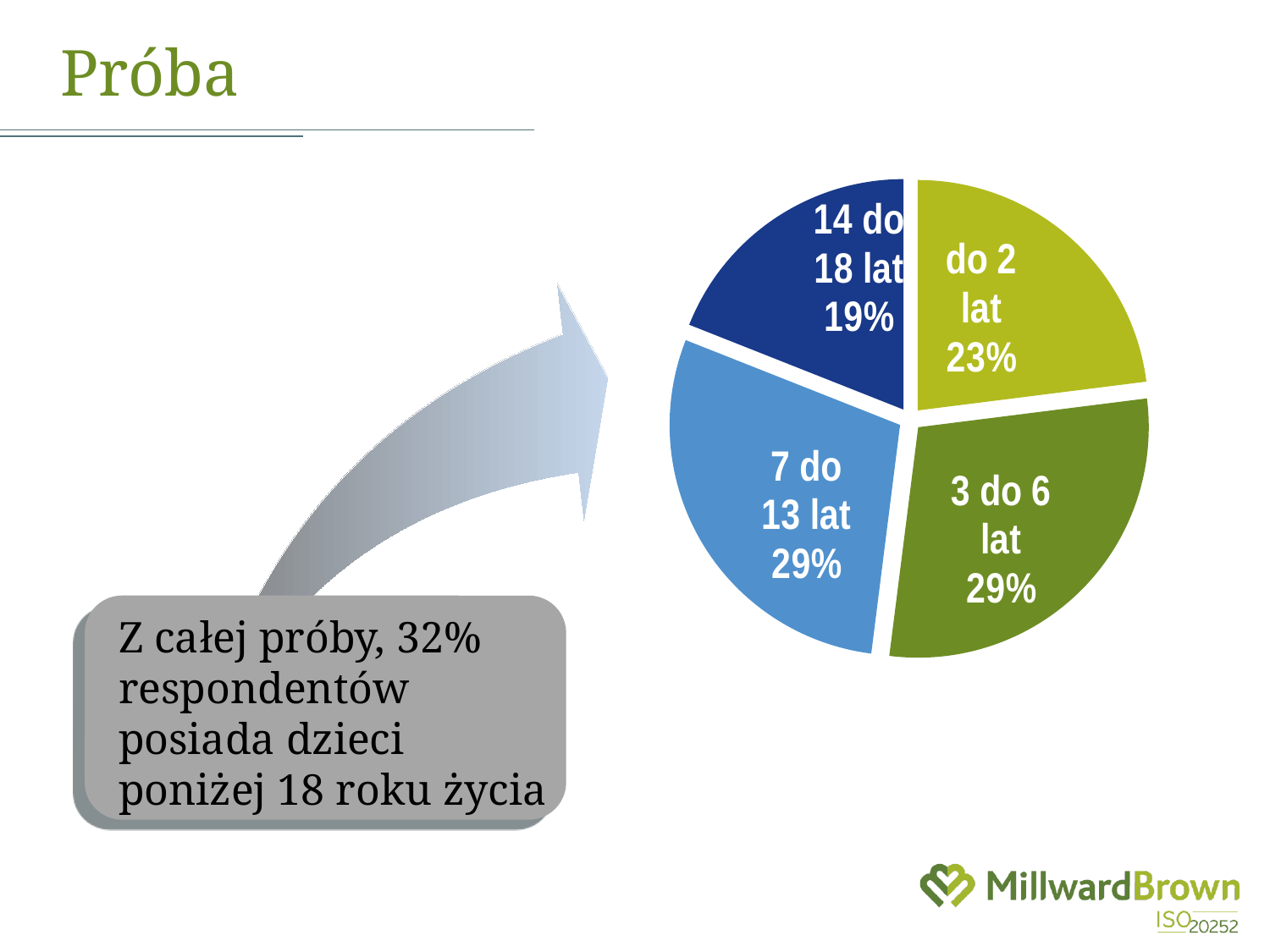
Which is larger, the "do 2 lat" slice or the "14 do 18 lat" slice? do 2 lat What is the difference in percentage points between the "do 2 lat" slice and the "14 do 18 lat" slice? 4 How many slices does the pie chart have? 4 Which slice of the pie chart is the smallest? 14 do 18 lat What is the difference in percentage points between the "3 do 6 lat" slice and the "14 do 18 lat" slice? 10 What colour is the "14 do 18 lat" slice of the pie chart? dark blue What is the value shown for the "14 do 18 lat" slice? 19% What is the title of the slide containing the pie chart? Próba What is the value shown for the "3 do 6 lat" slice? 29% What is the value shown for the "7 do 13 lat" slice? 29% What kind of chart is shown on the slide? pie chart What share of the pie does the "do 2 lat" slice represent? 23%